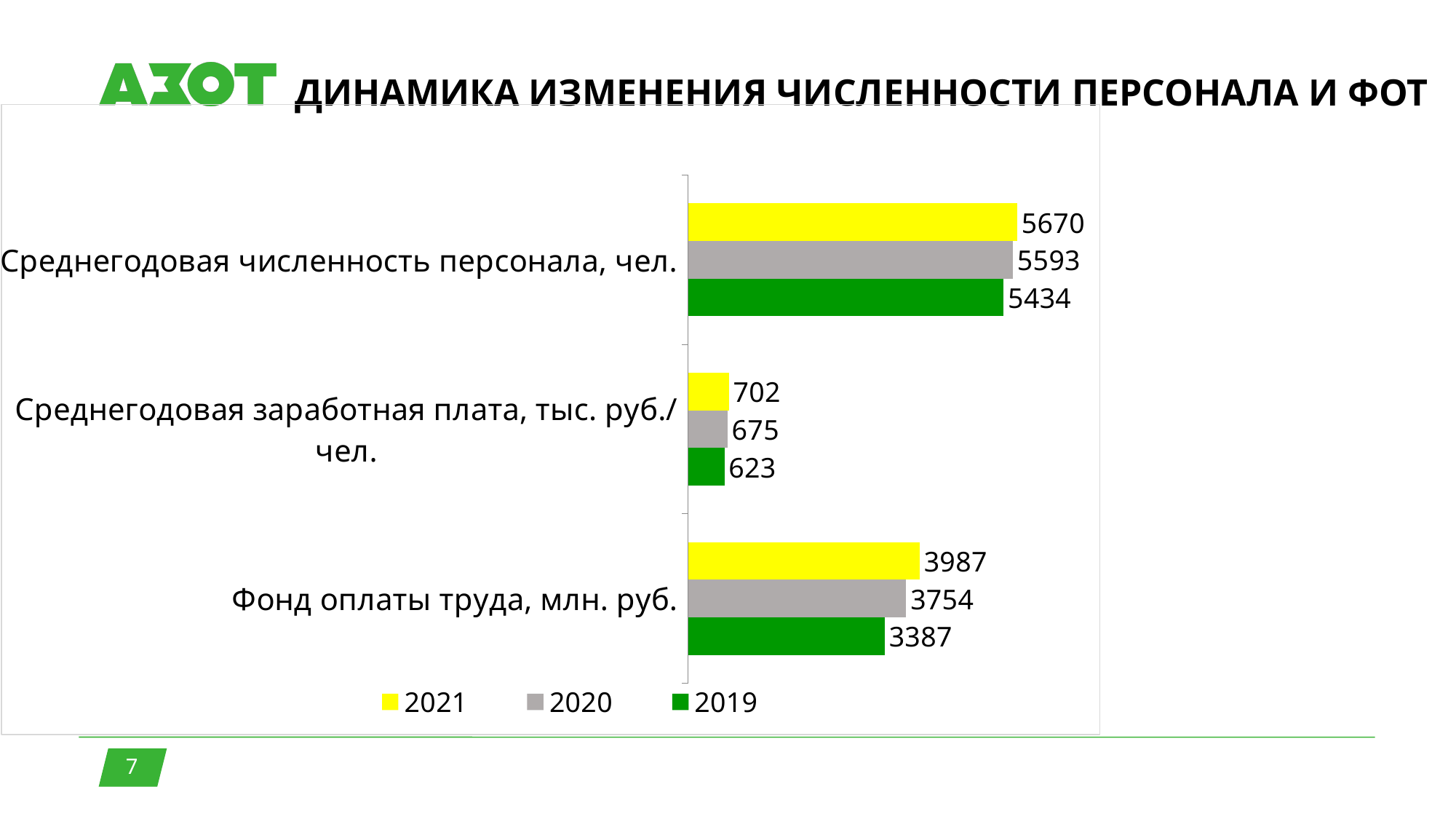
What is the difference between the 2021 and 2019 values for "Среднегодовая численность персонала, чел."? 236 What is the difference between the 2021 and 2020 values for "Фонд оплаты труда, млн. руб."? 233 What kind of chart is shown on the slide? Bar chart How many series does the legend list? 3 Which year has the lowest value for "Среднегодовая численность персонала, чел."? 2019 How many categories are shown on the chart? 3 What is the value for 2021 in the category "Среднегодовая численность персонала, чел."? 5670 Which year has the highest value for "Фонд оплаты труда, млн. руб."? 2021 Which is larger: the 2020 value or the 2019 value for "Среднегодовая заработная плата, тыс. руб./чел."? 2020 What is the value for 2019 in the category "Среднегодовая заработная плата, тыс. руб./чел."? 623 Which colour represents the year 2019 in the chart? Green What is the value for 2020 in the category "Фонд оплаты труда, млн. руб."? 3754